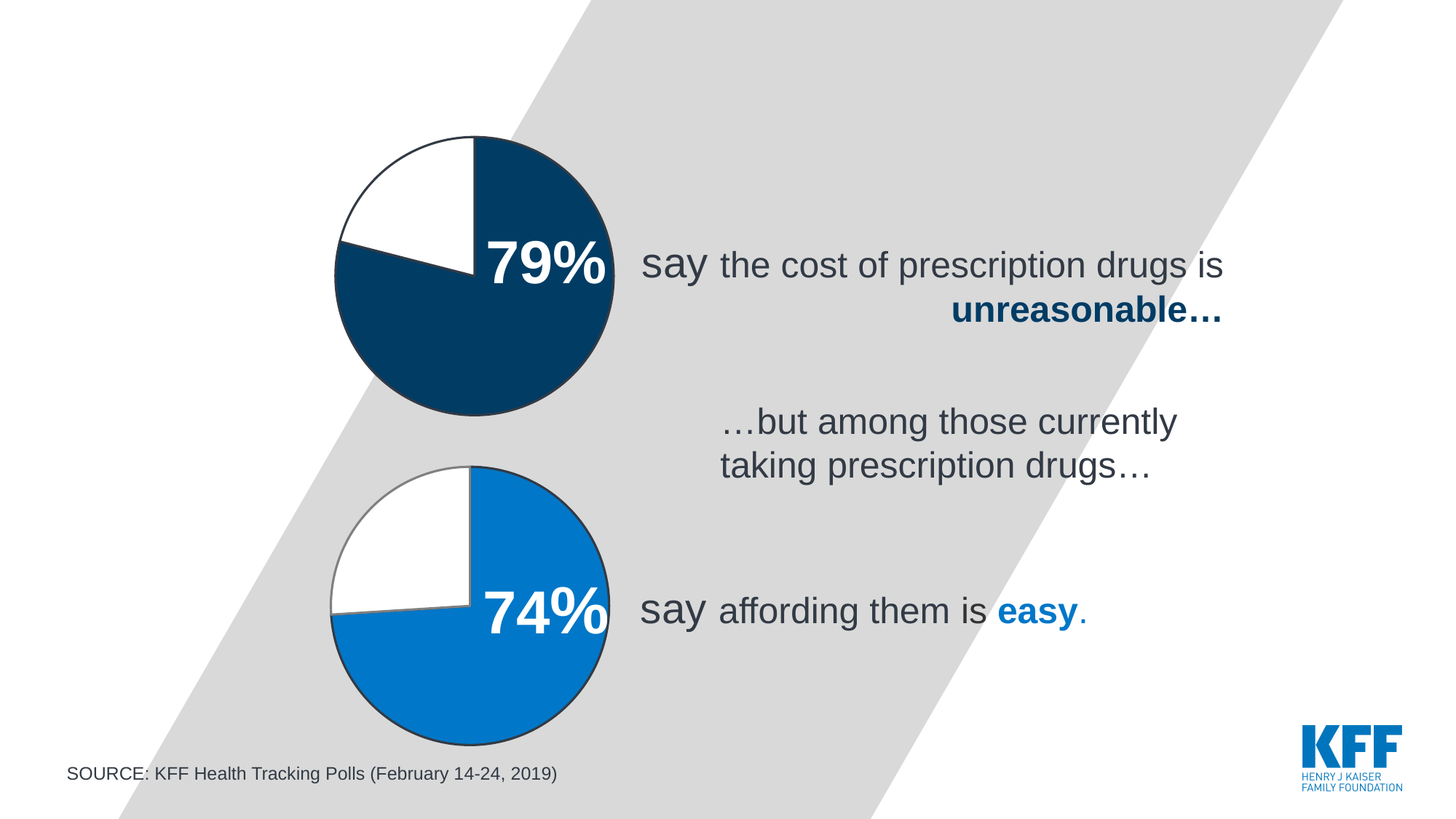
What source is cited for the data on the slide? KFF Health Tracking Polls (February 14-24, 2019) What colour is the labelled slice on the bottom pie chart? Light blue On the top pie chart, what share of the pie does the dark blue slice represent? 79% On the top pie chart, what percentage say the cost of prescription drugs is unreasonable? 79% On the top pie chart, which slice is larger: the dark blue slice or the white slice? The dark blue slice On the bottom pie chart, what percentage of those currently taking prescription drugs say affording them is easy? 74% How many slices does the top pie chart have? 2 Which is larger: the labelled share on the top pie chart or the labelled share on the bottom pie chart? The top pie chart (79%) What kind of chart is used on this slide to show the 79% and 74% figures? Pie chart On the bottom pie chart, what share of the pie does the blue slice represent? 74% What is the difference in percentage points between the 79% on the top pie chart and the 74% on the bottom pie chart? 5 percentage points How many pie charts are shown on the slide? 2